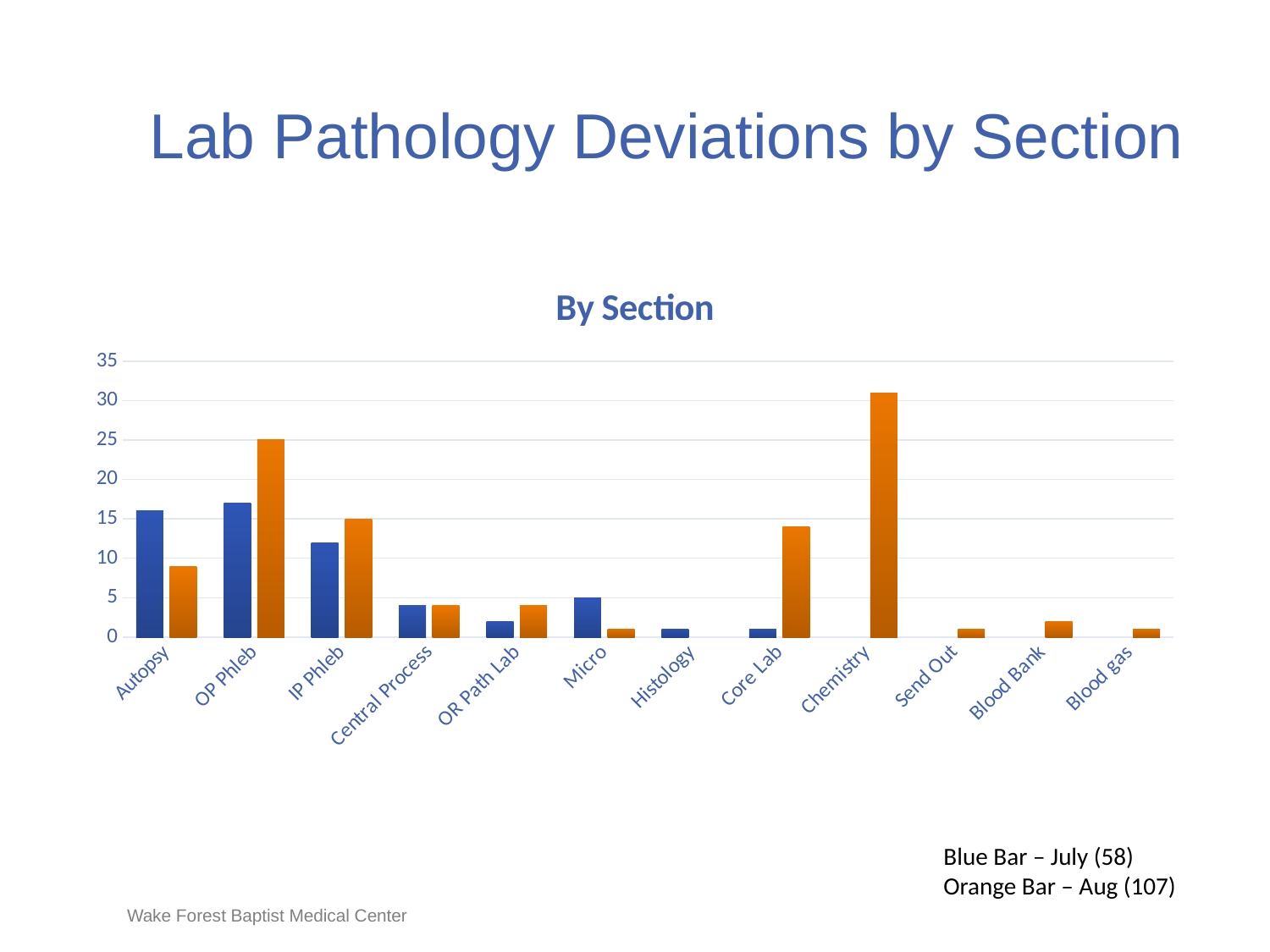
What is the value of the orange (Aug) bar for IP Phleb? 15 For Autopsy, which bar is taller, the blue (July) bar or the orange (Aug) bar? blue (July) What is the value of the blue (July) bar for Micro? 5 Is the value of the orange (Aug) bar for Chemistry greater or less than 30? greater According to the note on the slide, which month does the orange bar represent? Aug Is the value of the blue (July) bar for Autopsy greater or less than 15? greater Which section has the tallest bar in the chart? Chemistry How many sections (categories) are shown on the x axis of the chart? 12 Is the value of the orange (Aug) bar for Core Lab greater or less than 15? less What is the title shown above the chart? By Section What is the value of the orange (Aug) bar for OP Phleb? 25 What kind of chart is shown on the slide? bar chart